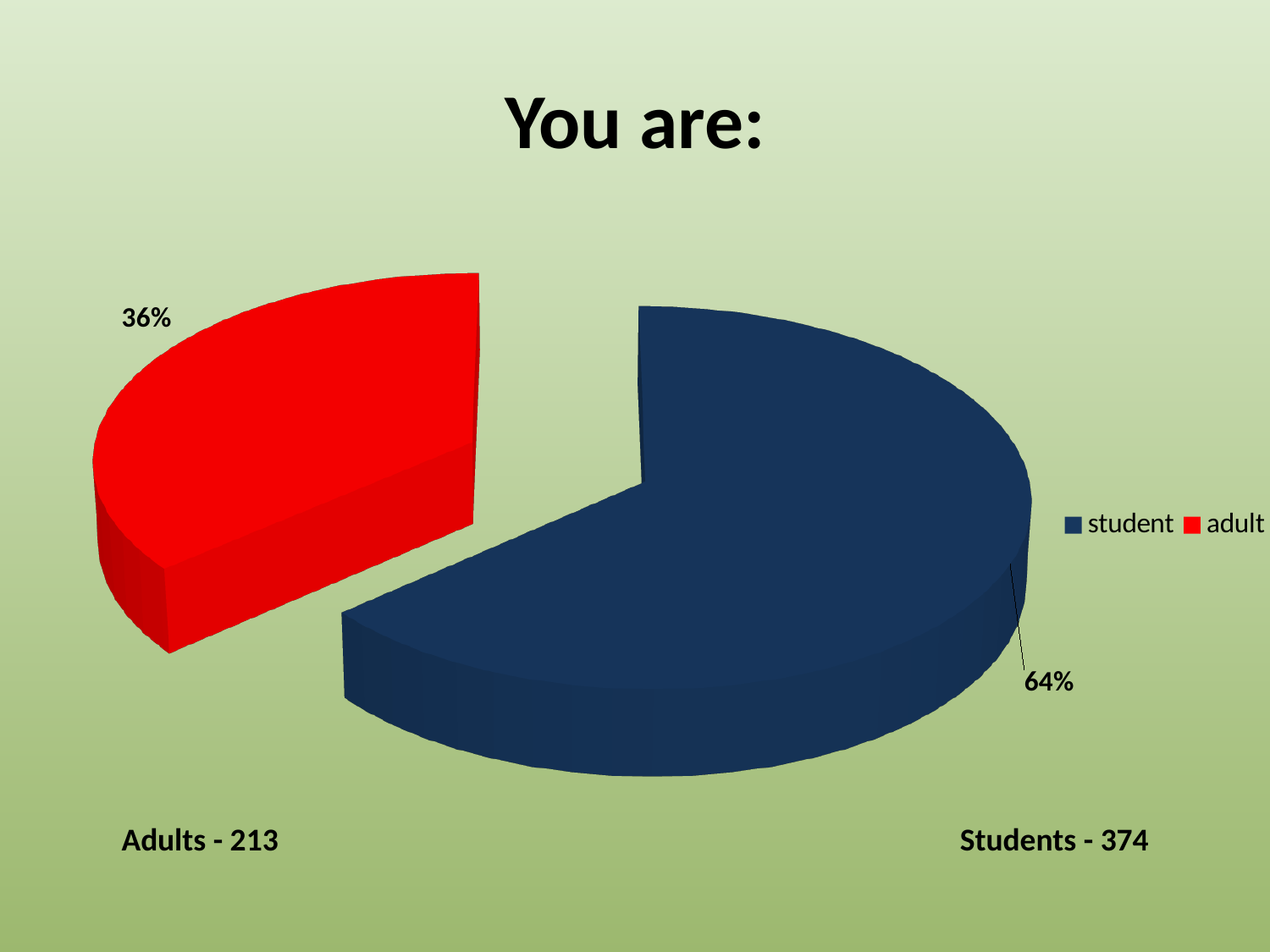
Which slice is larger, student or adult? student How many entries does the legend list? 2 What percentage of the pie does the adult slice represent? 36% Which category has the largest share of the pie? student What kind of chart is shown on the slide? pie chart Which category has the smallest share of the pie? adult What is the title of the slide? You are: How many slices does the pie chart have? 2 Is the share for the student slice greater or less than 50%? greater What is the difference in percentage points between the student and adult slices? 28 What percentage of the pie does the student slice represent? 64% What colour is the adult slice? red